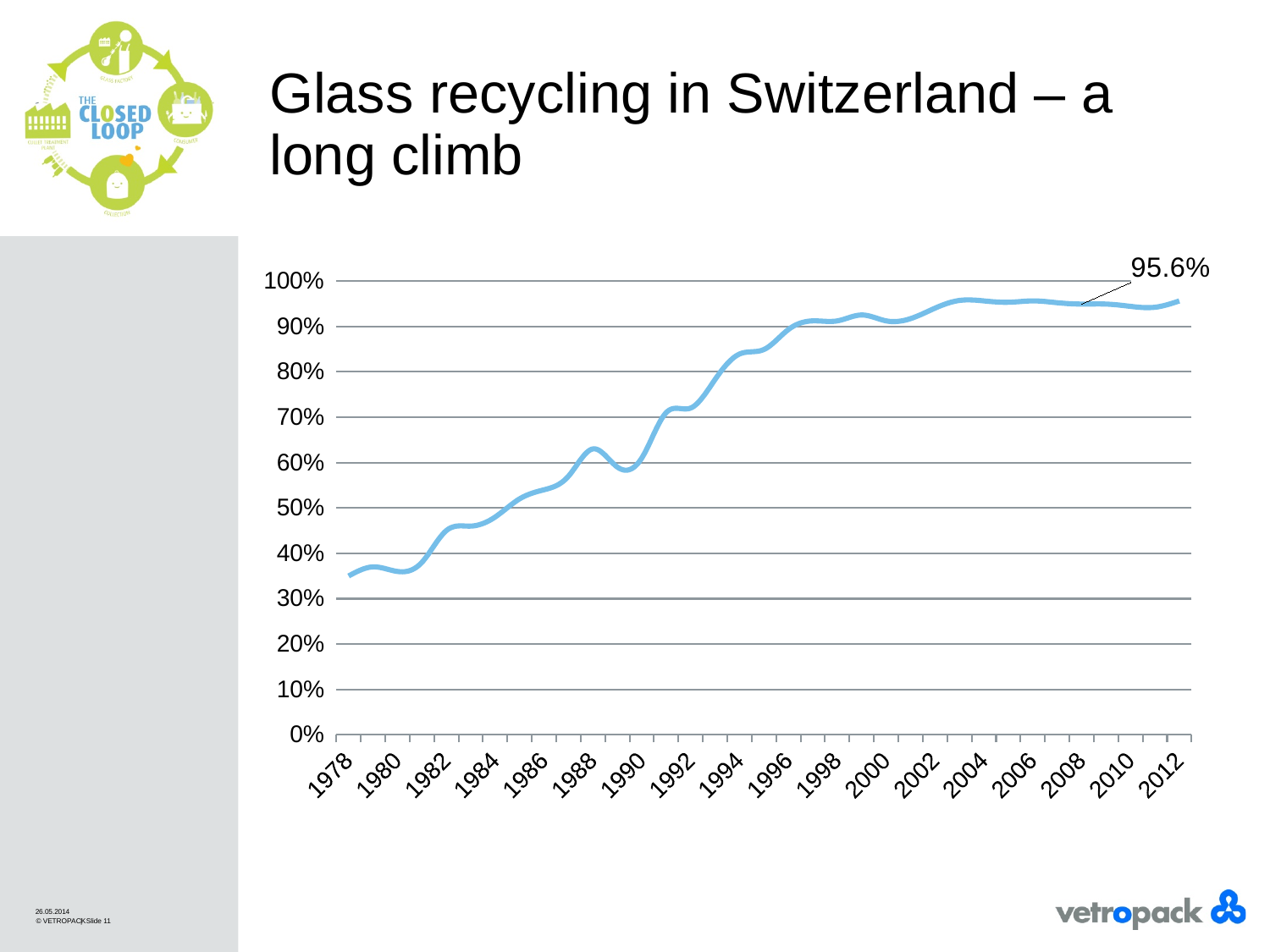
What is the title of the slide containing the chart? Glass recycling in Switzerland – a long climb Which year on the x axis has the lowest recycling rate? 1978 What kind of chart is shown on the slide? line chart Which year has the higher recycling rate, 1988 or 1990? 1988 How many year labels are shown on the x axis? 18 Is the value for 1994 greater or less than 80%? greater Overall, does the glass recycling rate rise or fall from 1978 to 2012? rise Is the value for 2000 greater or less than 90%? greater Is the value for 1978 greater or less than 40%? less What is the only data value labelled on the chart? 95.6%